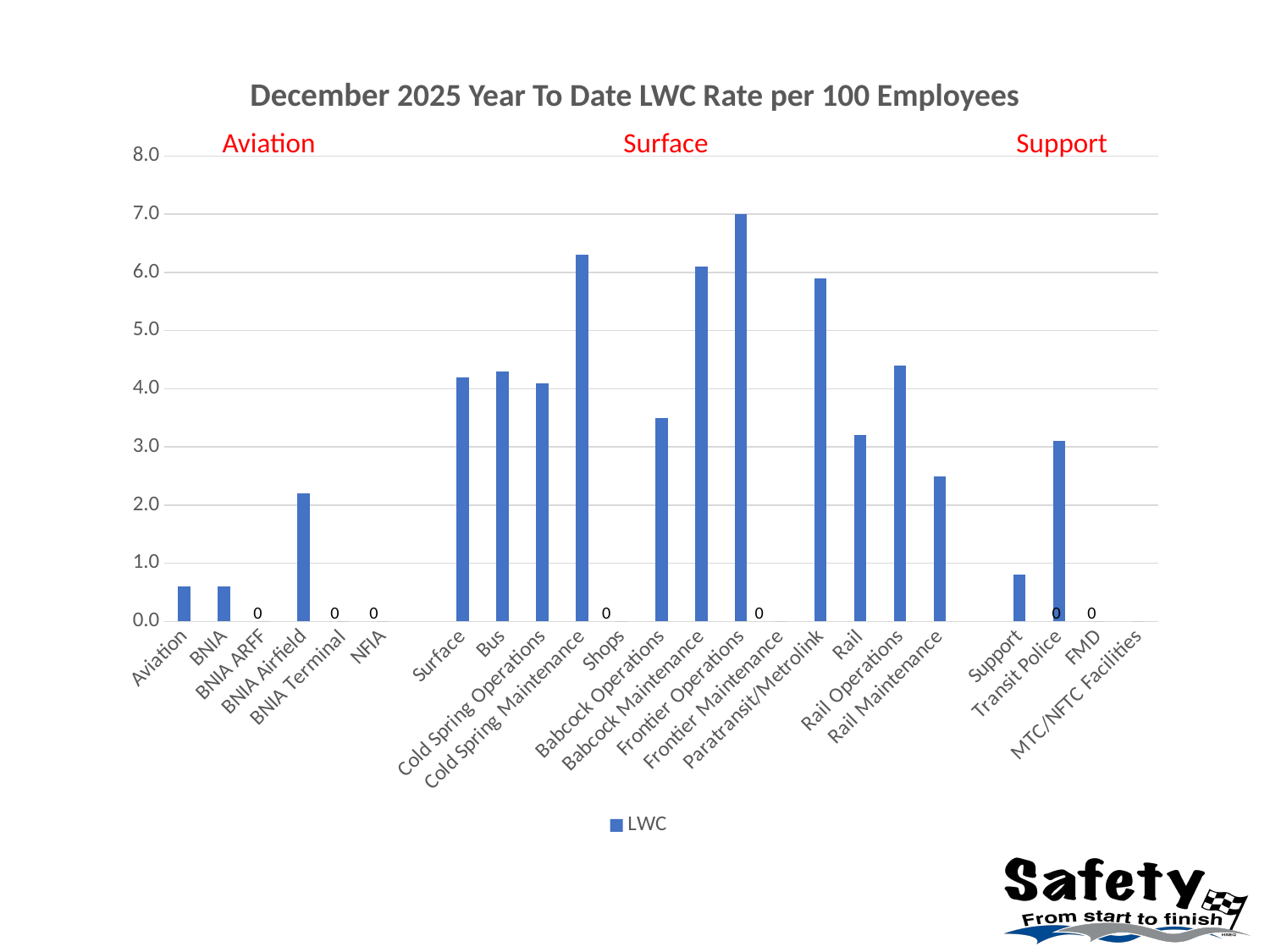
What is the LWC rate for Frontier Maintenance? 0 What is the LWC rate for BNIA ARFF? 0 How many series does the legend list? 1 Which is larger, the LWC rate for Rail Operations or for Rail? Rail Operations What is the LWC rate for Shops? 0 What is the title of the chart? December 2025 Year To Date LWC Rate per 100 Employees Is the value for Frontier Operations greater or less than 6.0? greater How many categories are shown on the x axis? 23 What is the name of the series shown in the legend? LWC Which category has the highest LWC rate? Frontier Operations Is the value for Support greater or less than 1.0? less What kind of chart is shown on the slide? bar chart